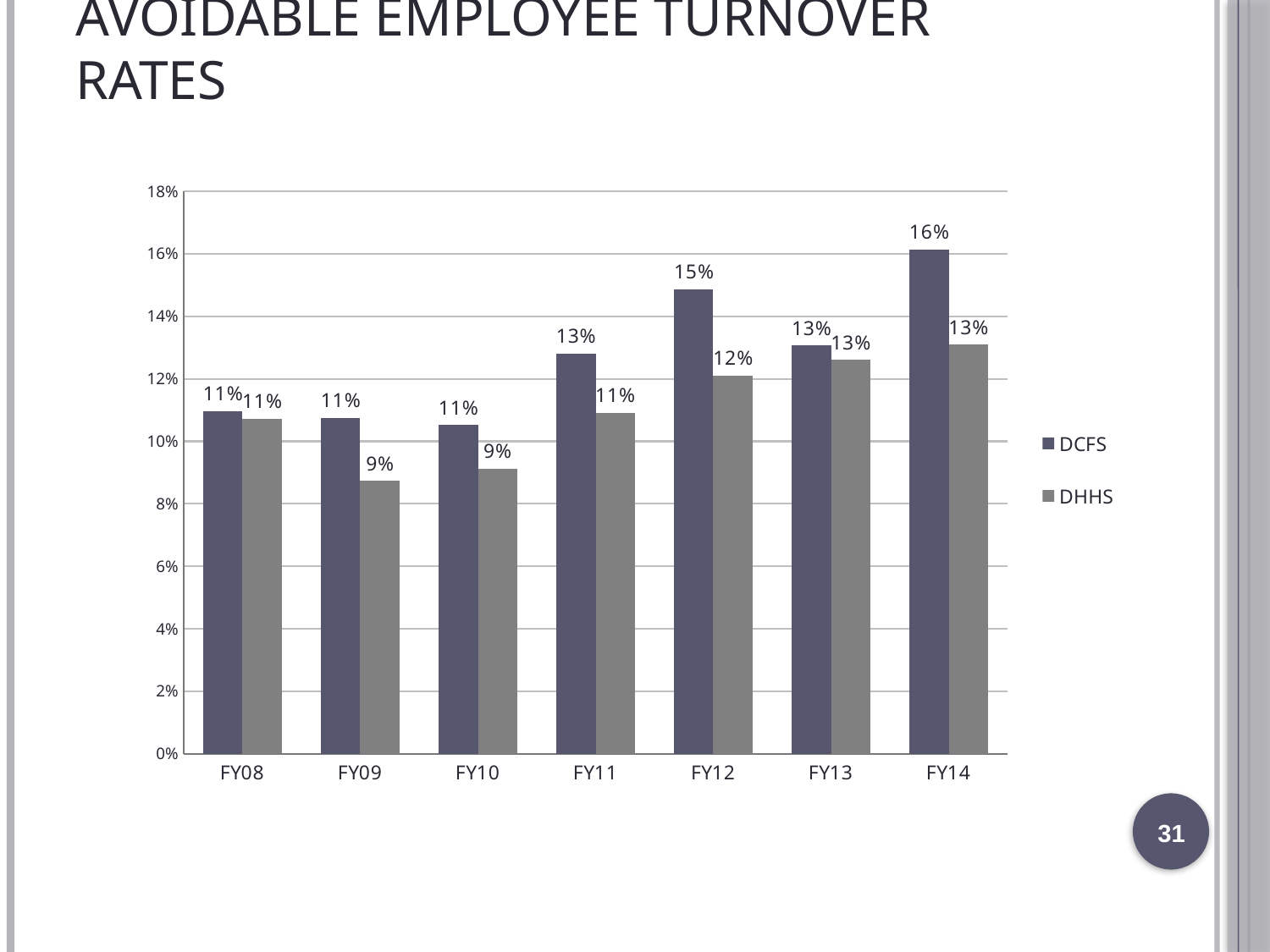
In which fiscal year is the DCFS turnover rate highest? FY14 What kind of chart is shown on the slide? Bar chart What is the DCFS avoidable turnover rate for FY14? 16% Is the DCFS value for FY12 greater or less than 14%? greater What is the DCFS value for FY12? 15% In FY11, which series has the higher turnover rate, DCFS or DHHS? DCFS How many fiscal years are shown on the x axis? 7 What is the DHHS avoidable turnover rate for FY09? 9% What is the difference between the DCFS and DHHS rates in FY09? 2% How many series does the legend list? 2 What is the DHHS value for FY12? 12% What is the difference between the DCFS and DHHS rates in FY12? 3%